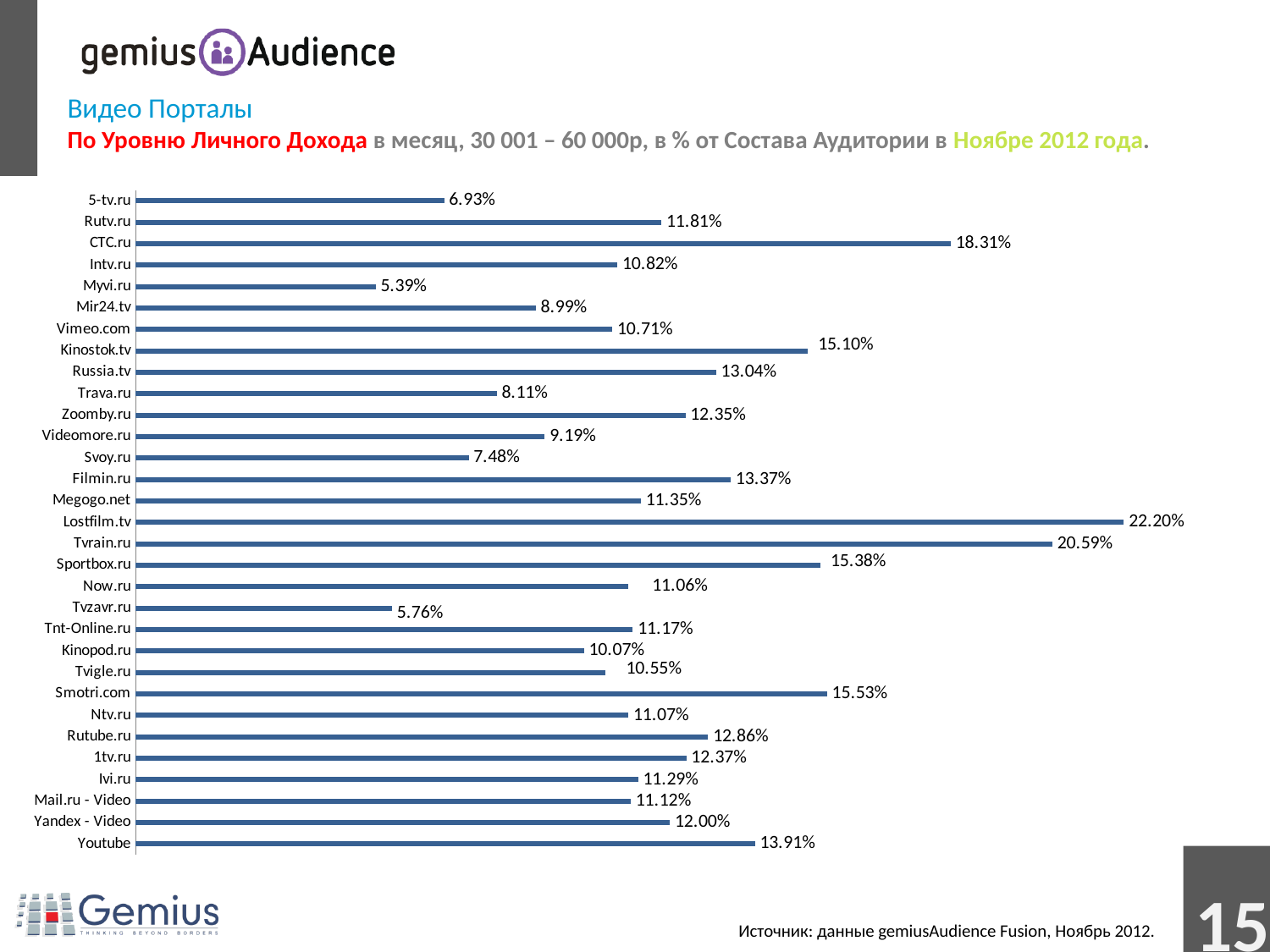
What is the value for Kinostok.tv? 15.10% What kind of chart is shown on the slide? Bar chart Which has a larger value, Smotri.com or Sportbox.ru? Smotri.com How many portals are shown in the chart? 31 What is the value for Myvi.ru? 5.39% What is the value for Youtube? 13.91% Which portal has the highest value? Lostfilm.tv What is the difference between the values for CTC.ru and Youtube? 4.40% Which has a larger value, Rutube.ru or Russia.tv? Russia.tv What is the difference between the values for Lostfilm.tv and Tvrain.ru? 1.61% Which portal has the lowest value? Myvi.ru What is the value for Lostfilm.tv? 22.20%